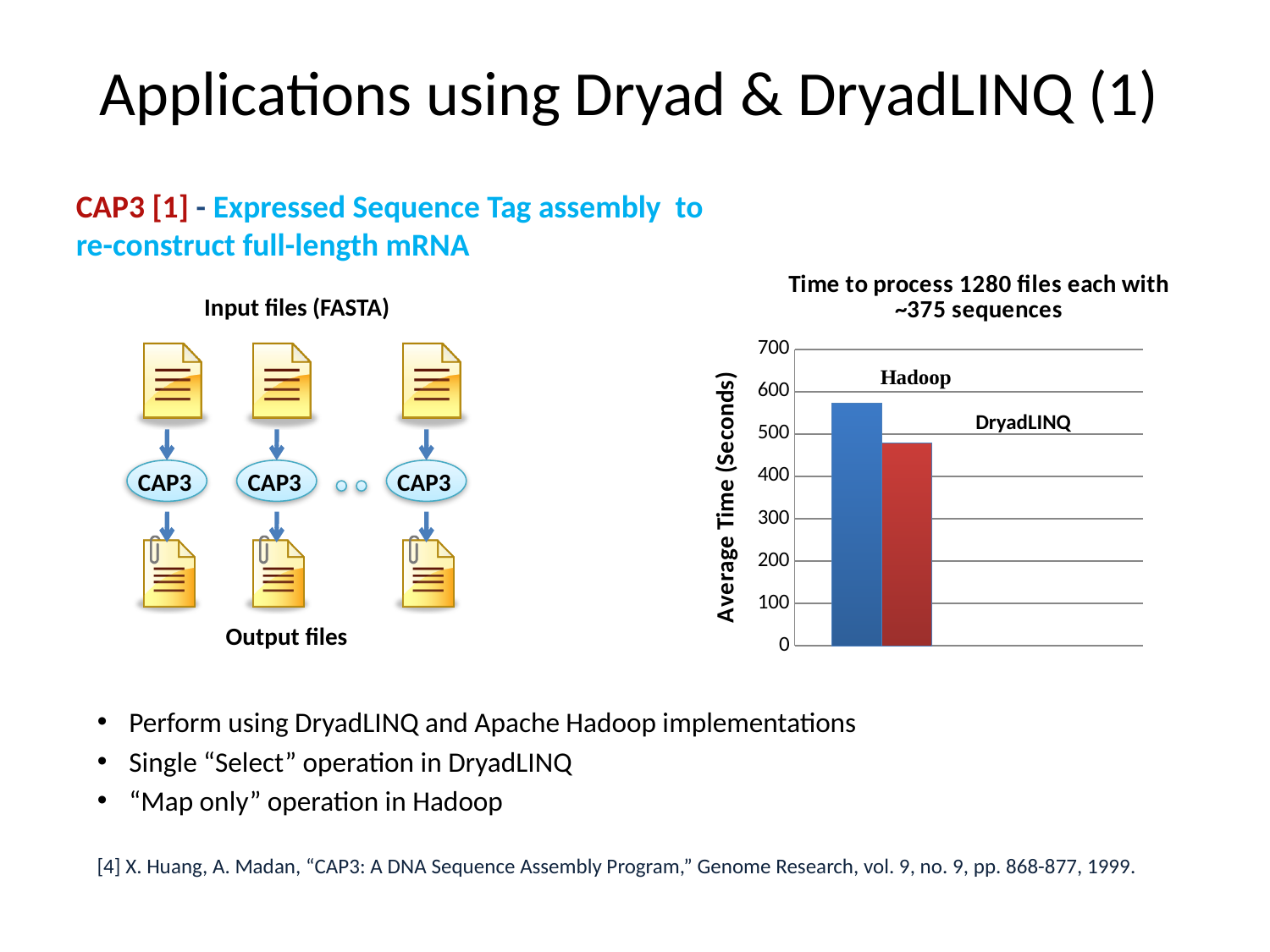
Is the average time for Hadoop greater or less than 600 seconds? less Which has a larger average time, Hadoop or DryadLINQ? Hadoop Which implementation has the lowest average time in the chart? DryadLINQ Which implementation has the highest average time in the chart? Hadoop How many bars are plotted in the chart? 2 Is the average time for DryadLINQ greater or less than 400 seconds? greater Is the average time for Hadoop greater or less than 500 seconds? greater What kind of chart is shown on the slide? bar chart What is the title of the chart? Time to process 1280 files each with ~375 sequences What is the label of the vertical axis of the chart? Average Time (Seconds)